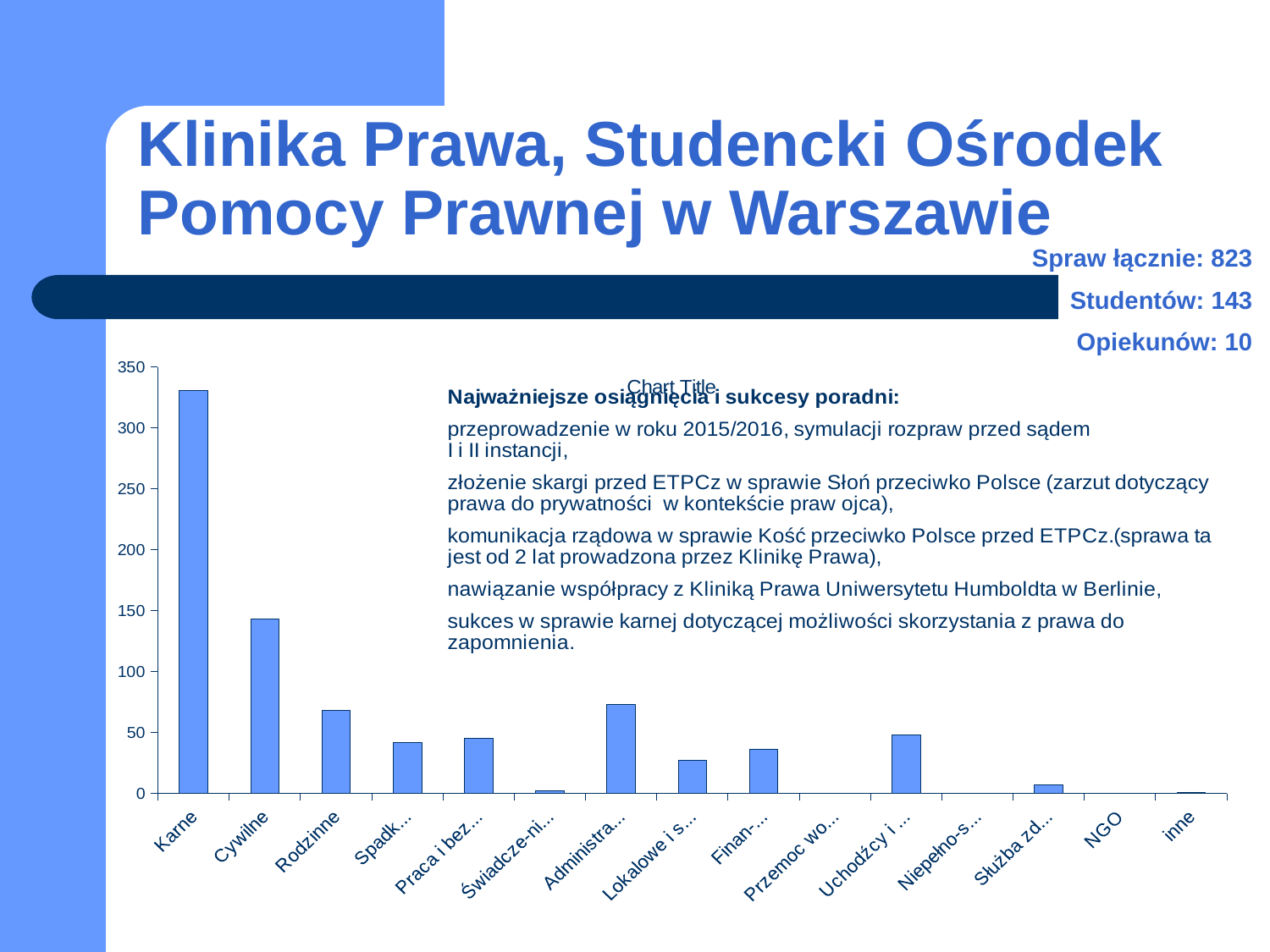
Is the value for Karne greater or less than 300? greater How many categories are shown on the x axis of the chart? 15 Which is larger, the value for Cywilne or the value for Rodzinne? Cywilne Is the value for Rodzinne greater or less than 100? less Which is larger, the value for Karne or the value for Cywilne? Karne Is the value for NGO greater or less than 50? less What is the title shown on the chart? Chart Title Which category has the highest bar in the chart? Karne What kind of chart is shown on the slide? bar chart